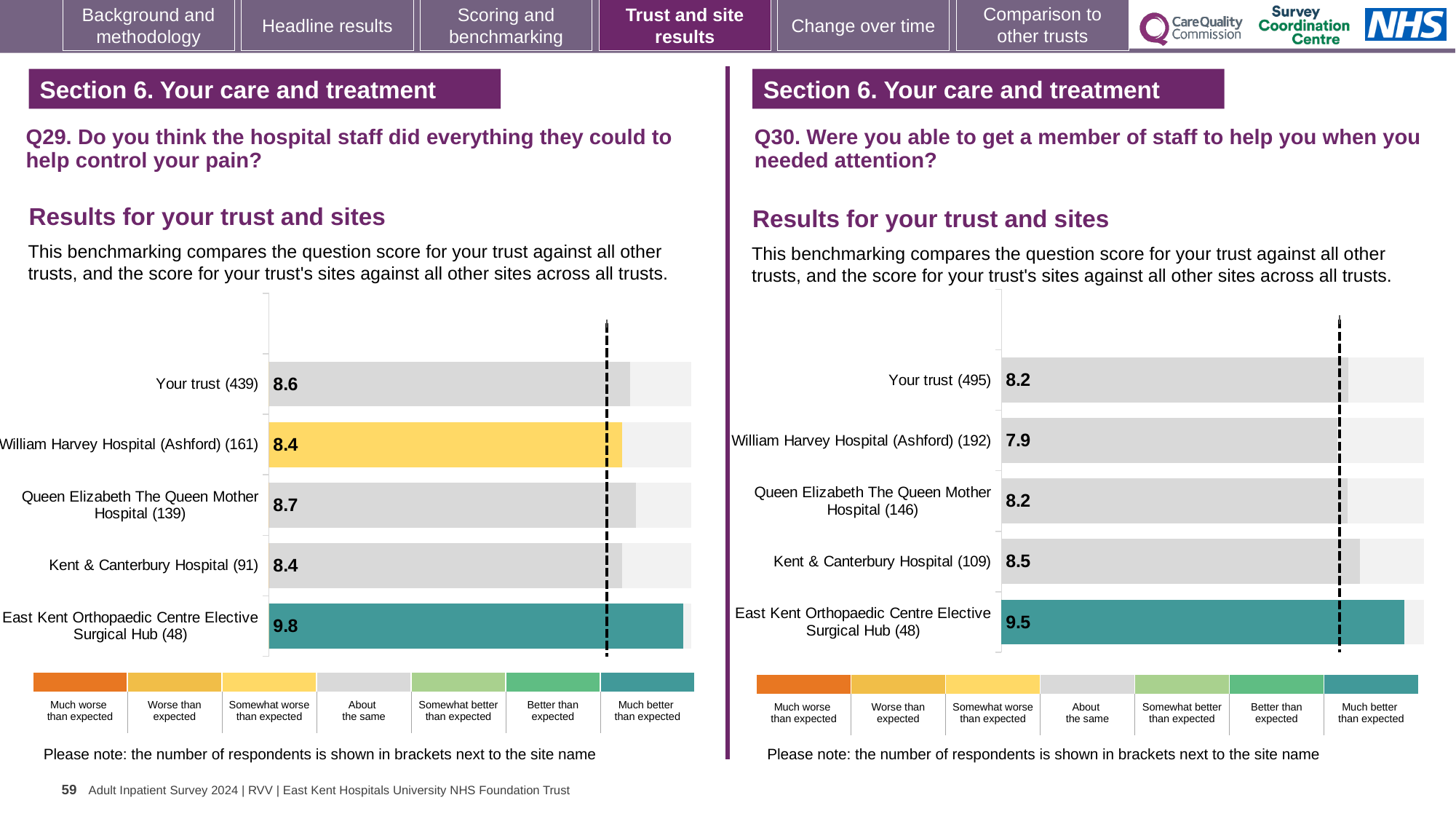
In the Q30 chart on the right, which is larger: the score for Kent & Canterbury Hospital or the score for Your trust? Kent & Canterbury Hospital In the Q30 chart on the right, what is the difference between the scores for East Kent Orthopaedic Centre Elective Surgical Hub and Your trust? 1.3 In the Q30 chart on the right, which site has the lowest score? William Harvey Hospital (Ashford) In the Q29 chart on the left, how many bars are plotted? 5 In the Q30 chart on the right, what is the score for Kent & Canterbury Hospital? 8.5 In the Q29 chart on the left, which site has the highest score? East Kent Orthopaedic Centre Elective Surgical Hub In the Q30 chart on the right, what is the score for William Harvey Hospital (Ashford)? 7.9 In the Q29 chart on the left, what is the score for East Kent Orthopaedic Centre Elective Surgical Hub? 9.8 In the Q29 chart on the left, what is the score for Your trust? 8.6 In the Q30 chart on the right, how many respondents are shown in brackets for Your trust? 495 What type of chart is used in the Q29 chart on the left? Bar chart In the Q29 chart on the left, what is the difference between the scores for Queen Elizabeth The Queen Mother Hospital and William Harvey Hospital (Ashford)? 0.3